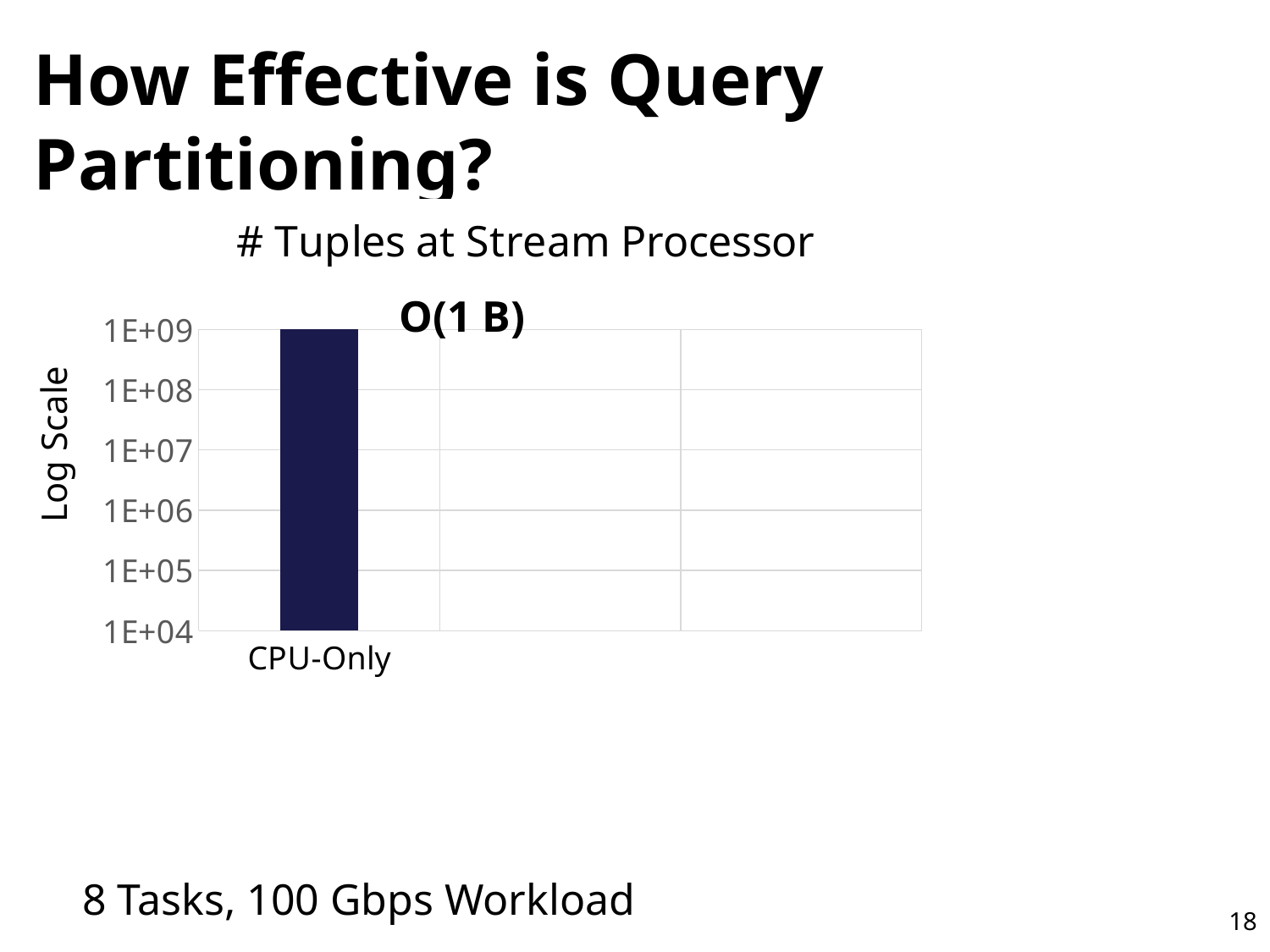
What is the title of the chart? # Tuples at Stream Processor Which category is labelled on the horizontal axis of the chart? CPU-Only What is the lowest tick value shown on the vertical axis? 1E+04 Is the value for CPU-Only greater or less than 1E+06? greater What value does the CPU-Only bar reach on the vertical axis? 1E+09 What kind of chart is shown on the slide? bar chart How many bars are plotted in the chart? 1 What is the highest tick value shown on the vertical axis? 1E+09 What is the label on the vertical axis of the chart? Log Scale Is the value for CPU-Only greater or less than 1E+08? greater What annotation is printed above the CPU-Only bar? O(1 B)